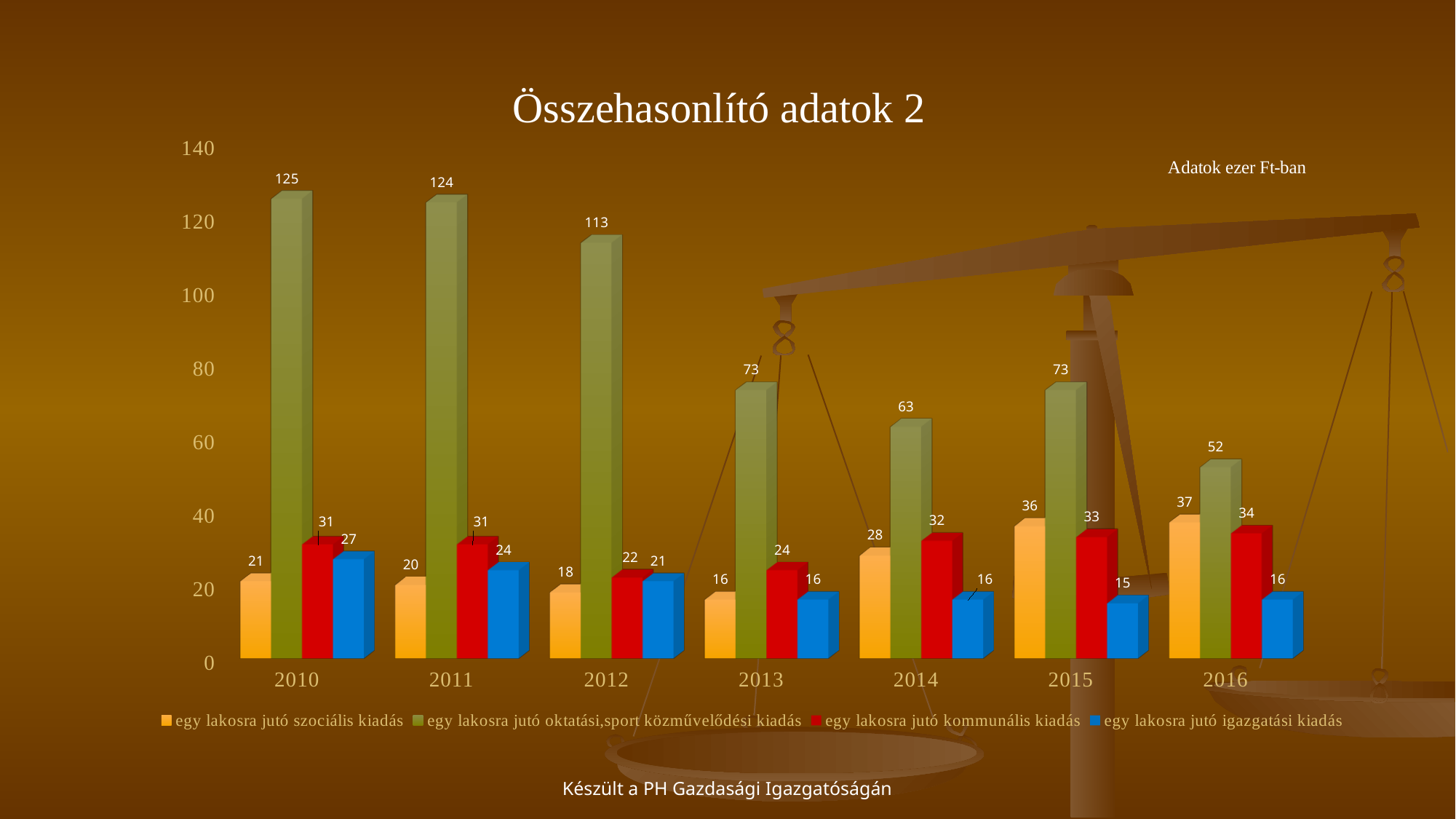
In which year is 'egy lakosra jutó oktatási,sport közművelődési kiadás' lowest? 2016 In which year is 'egy lakosra jutó szociális kiadás' highest? 2016 What kind of chart is shown on the slide? bar chart What is the value for 'egy lakosra jutó oktatási,sport közművelődési kiadás' in 2010? 125 Which is larger in 2014: 'egy lakosra jutó szociális kiadás' or 'egy lakosra jutó kommunális kiadás'? egy lakosra jutó kommunális kiadás How many years are shown on the x axis? 7 What is the value for 'egy lakosra jutó igazgatási kiadás' in 2015? 15 What unit note is printed at the top right of the chart? Adatok ezer Ft-ban What is the value for 'egy lakosra jutó szociális kiadás' in 2016? 37 What is the difference between the 'egy lakosra jutó oktatási,sport közművelődési kiadás' values for 2010 and 2016? 73 How many series does the legend list? 4 What is the value for 'egy lakosra jutó kommunális kiadás' in 2012? 22